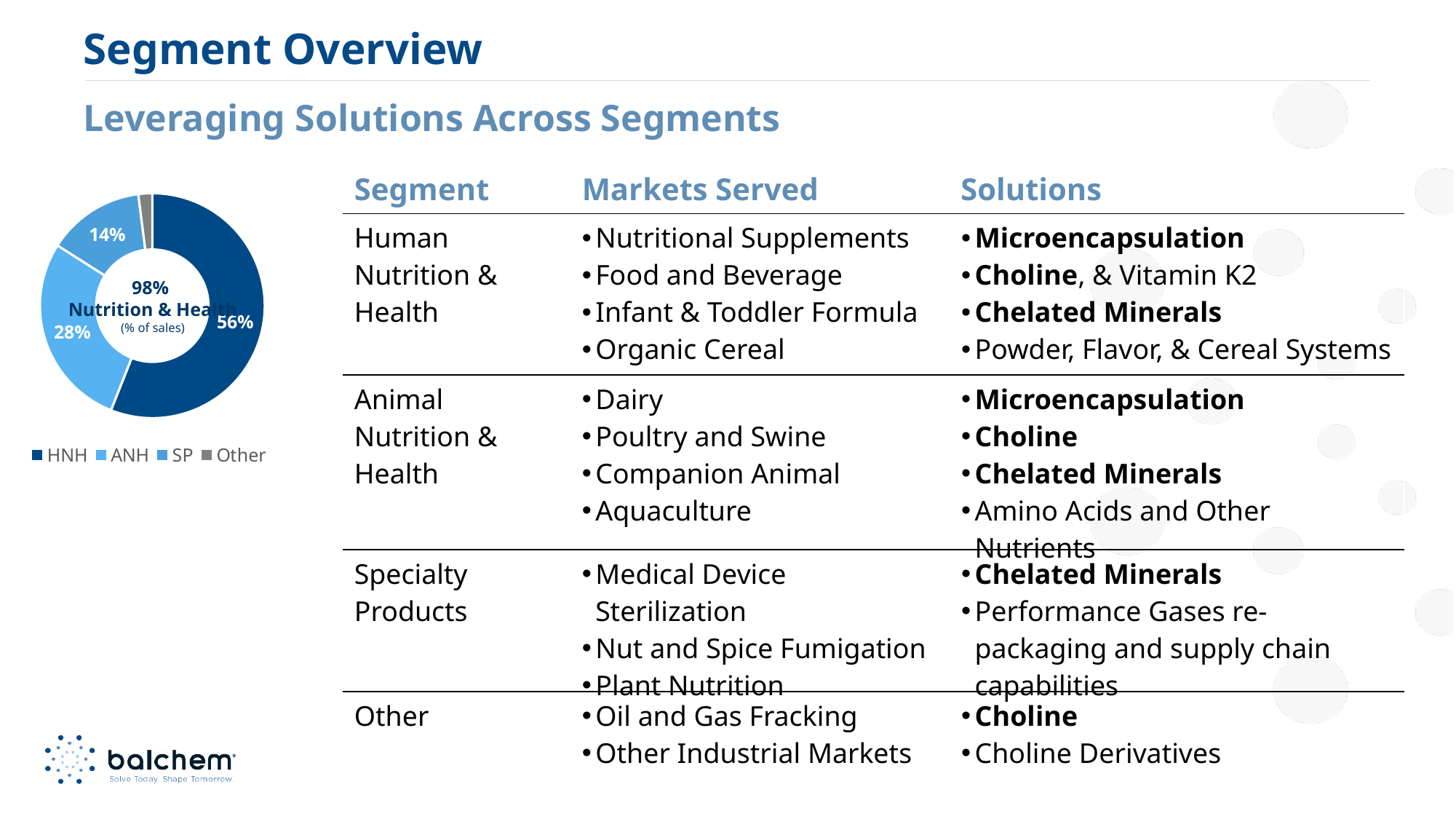
What type of chart is used to show the segment share of sales? Pie (donut) chart What are the legend entries of the donut chart, in order? HNH, ANH, SP, Other What is the combined share of sales for HNH and ANH? 84% What percentage is printed in the center of the donut chart for Nutrition & Health? 98% How many segments are shown in the donut chart's legend? 4 Which segment has the largest share of sales in the donut chart? HNH What percentage of sales does the HNH segment account for in the donut chart? 56% Which segment has a larger share of sales, ANH or SP? ANH How many percentage points larger is the HNH share than the ANH share? 28 percentage points What percentage of sales does the ANH segment account for in the donut chart? 28% What percentage of sales does the SP segment account for in the donut chart? 14% Which segment has the smallest slice in the donut chart? Other